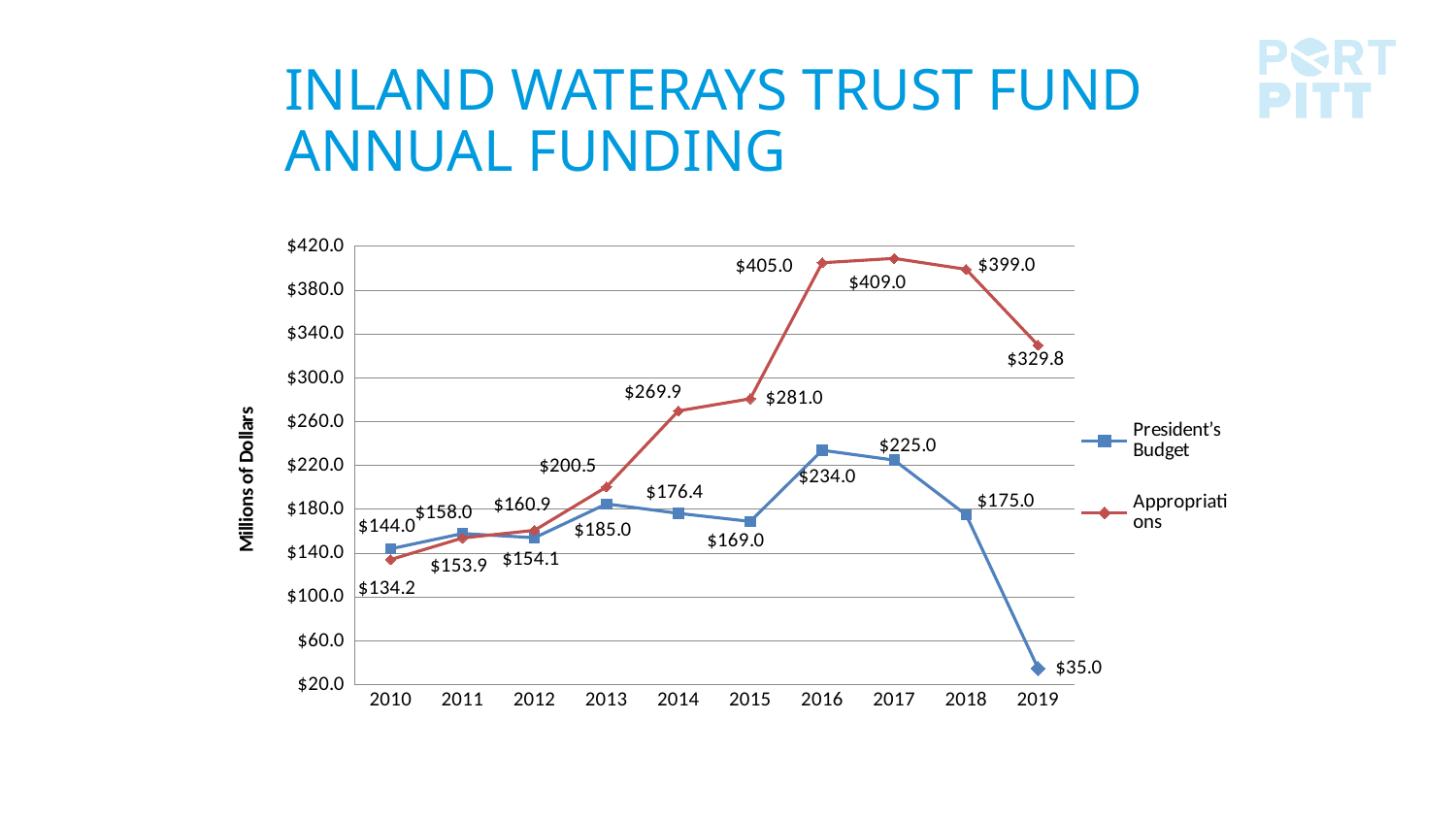
What is the President's Budget value for 2016? $234.0 What is the difference between Appropriations and President's Budget in 2018? $224.0 What is the President's Budget value for 2019? $35.0 Which is larger in 2011, the President's Budget or Appropriations? President's Budget How many years are shown on the x axis? 10 What is the Appropriations value for 2010? $134.2 In which year is the President's Budget value lowest? 2019 How many series does the legend list? 2 In which year is the Appropriations value highest? 2017 What kind of chart is shown on the slide? Line chart What is the Appropriations value for 2017? $409.0 What is the label on the vertical axis? Millions of Dollars